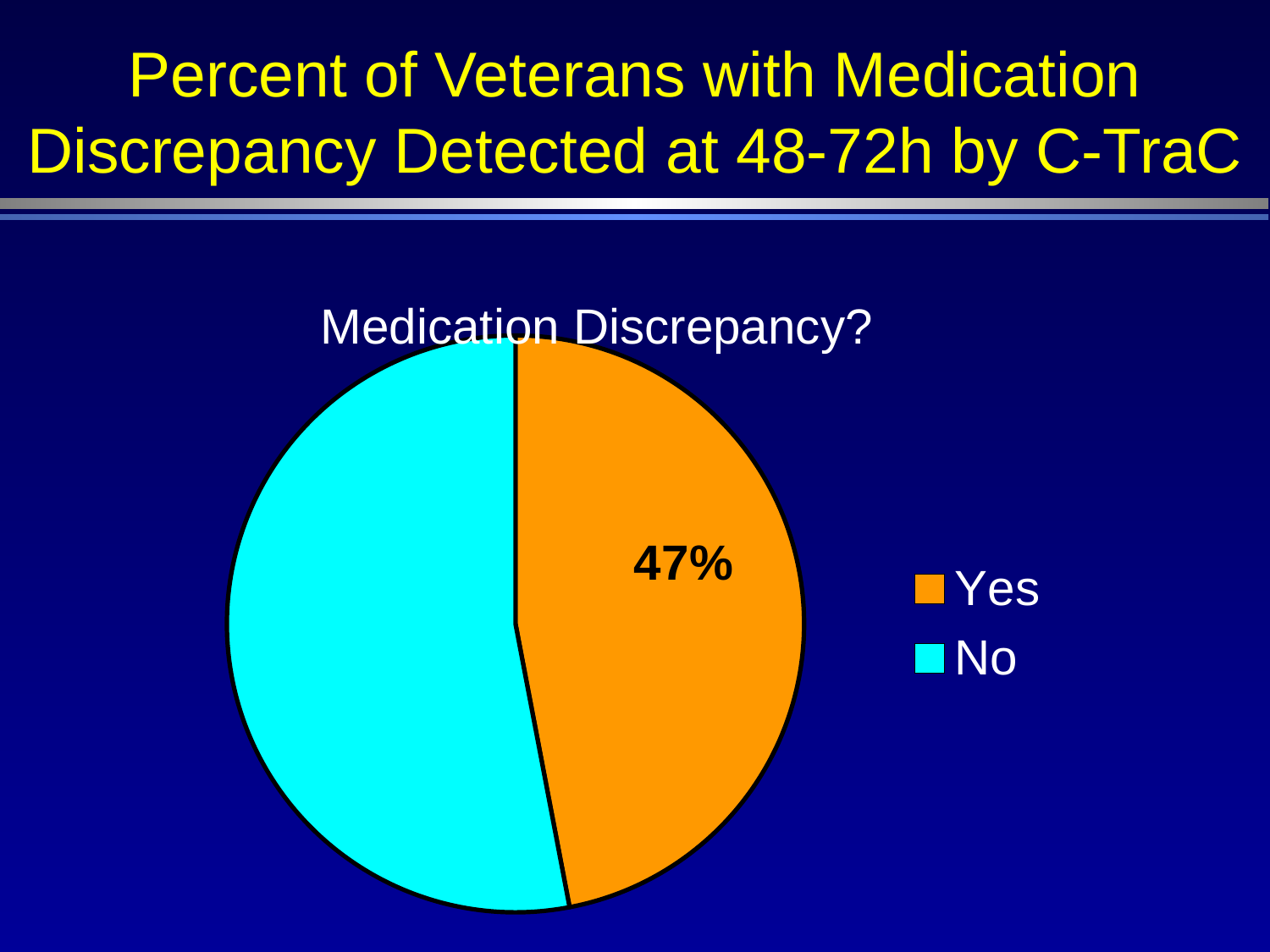
What percentage of the pie is labelled for the "Yes" slice? 47% What is the title of the chart? Medication Discrepancy? Which slice of the pie is the smallest? Yes How many entries does the legend list? 2 Which slice of the pie is the largest? No What colour is the "Yes" slice in the pie chart? Orange Which is larger, the "Yes" slice or the "No" slice? No What share of the pie does the "Yes" slice represent? 47% What kind of chart is shown on the slide? Pie chart How many slices does the pie chart have? 2